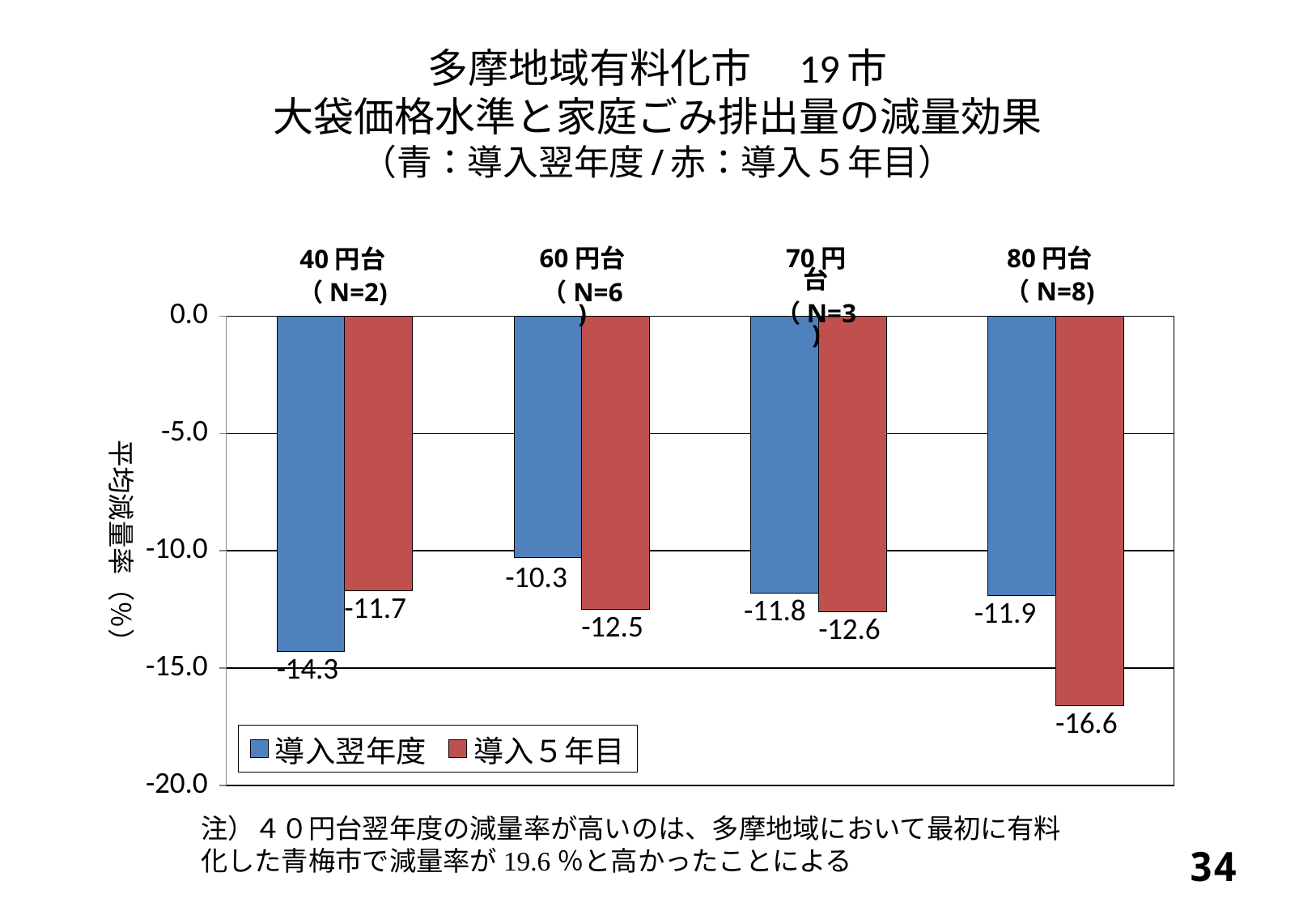
What is the difference between the 導入翌年度 and 導入５年目 values in the 80円台 category? 4.7 Which category has the lowest (most negative) value for 導入５年目? 80円台 What is the value for 導入５年目 in the 80円台 category? -16.6 How many price categories (円台) are shown on the x axis of the chart? 4 What are the two entries in the chart legend? 導入翌年度 and 導入５年目 Which category has the highest (least negative) value for 導入翌年度? 60円台 How many series does the chart legend list? 2 What is the value for 導入翌年度 in the 60円台 category? -10.3 What type of chart is shown on the slide? Bar chart What is the value for 導入翌年度 in the 40円台 category? -14.3 Does the 導入５年目 series rise or fall as you move from 40円台 to 80円台 along the x axis? Fall What is the value for 導入５年目 in the 70円台 category? -12.6